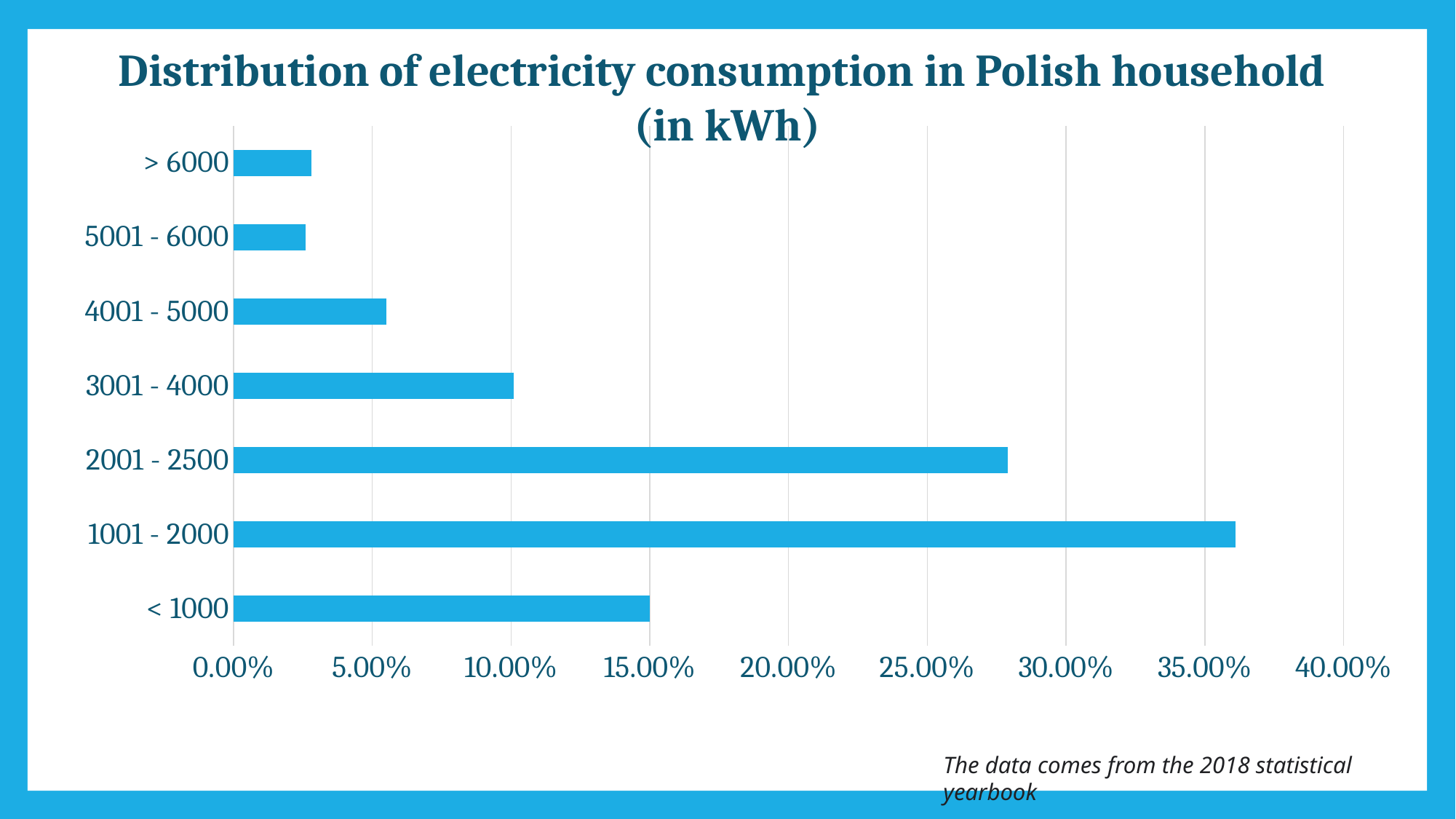
How many consumption categories are shown in the chart? 7 What is the title of the chart? Distribution of electricity consumption in Polish household (in kWh) Which consumption category has the highest share? 1001 - 2000 Which has a larger share, 2001 - 2500 or < 1000? 2001 - 2500 Is the value for 3001 - 4000 greater or less than 15.00%? less Is the value for < 1000 greater or less than 10.00%? greater Is the value for 4001 - 5000 greater or less than 10.00%? less What type of chart is shown on the slide? bar chart Which has a larger share, 3001 - 4000 or 4001 - 5000? 3001 - 4000